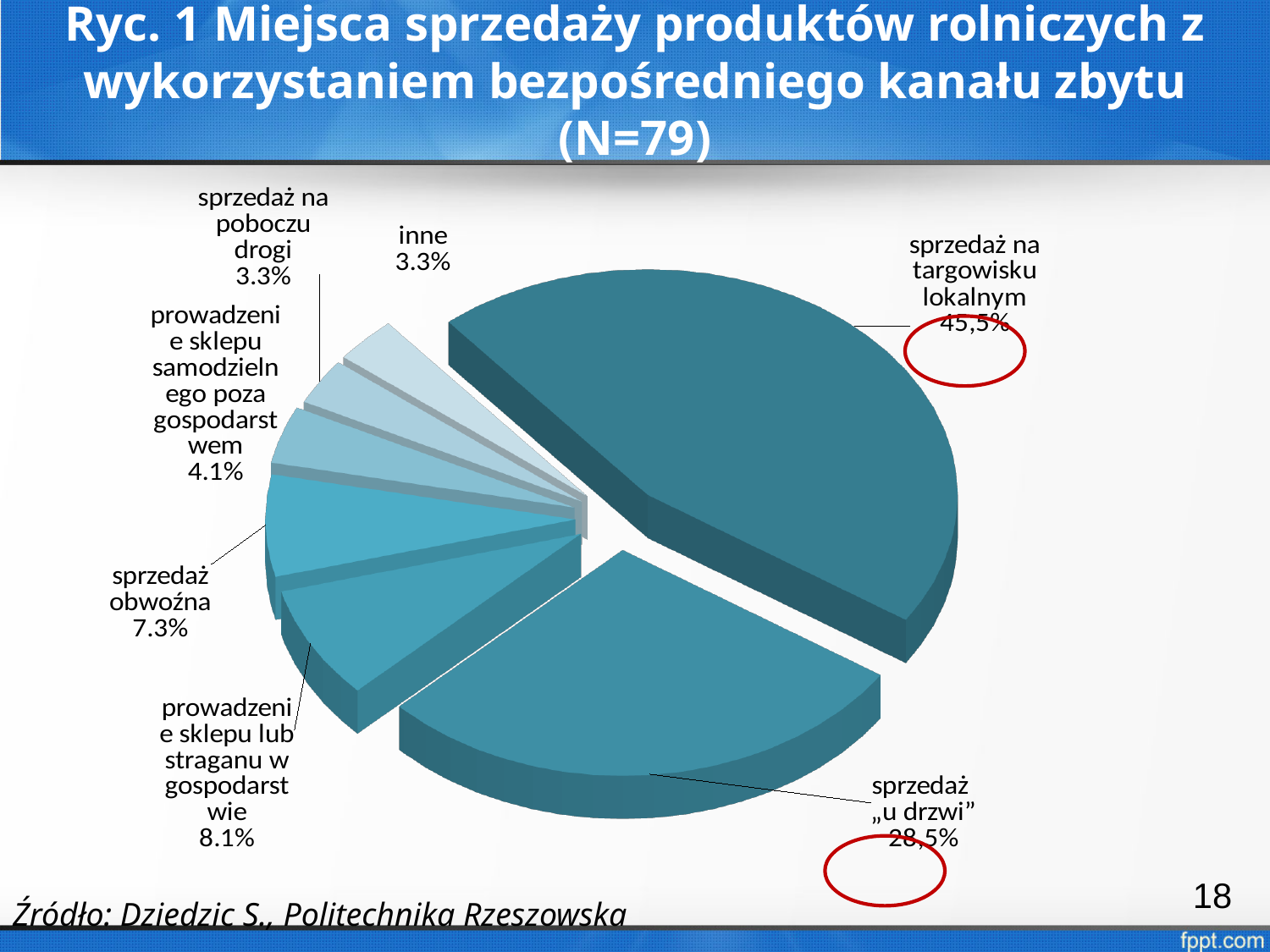
What is the difference between the shares of "prowadzenie sklepu lub straganu w gospodarstwie" and "sprzedaż obwoźna"? 0.8% Which category has the larger share: "sprzedaż obwoźna" or "prowadzenie sklepu samodzielnego poza gospodarstwem"? sprzedaż obwoźna What share of the pie is labelled for "sprzedaż na targowisku lokalnym"? 45,5% What type of chart is shown on the slide? pie chart What sample size (N) is given in the chart title? N=79 What percentage is shown for "sprzedaż obwoźna"? 7.3% What percentage is shown for "sprzedaż „u drzwi”"? 28,5% What is the difference in percentage points between "sprzedaż na targowisku lokalnym" and "sprzedaż „u drzwi”"? 17% How many slices does the pie chart have? 7 What percentage is shown for "inne"? 3.3% Which category has the largest slice of the pie? sprzedaż na targowisku lokalnym What percentage is shown for "prowadzenie sklepu lub straganu w gospodarstwie"? 8.1%